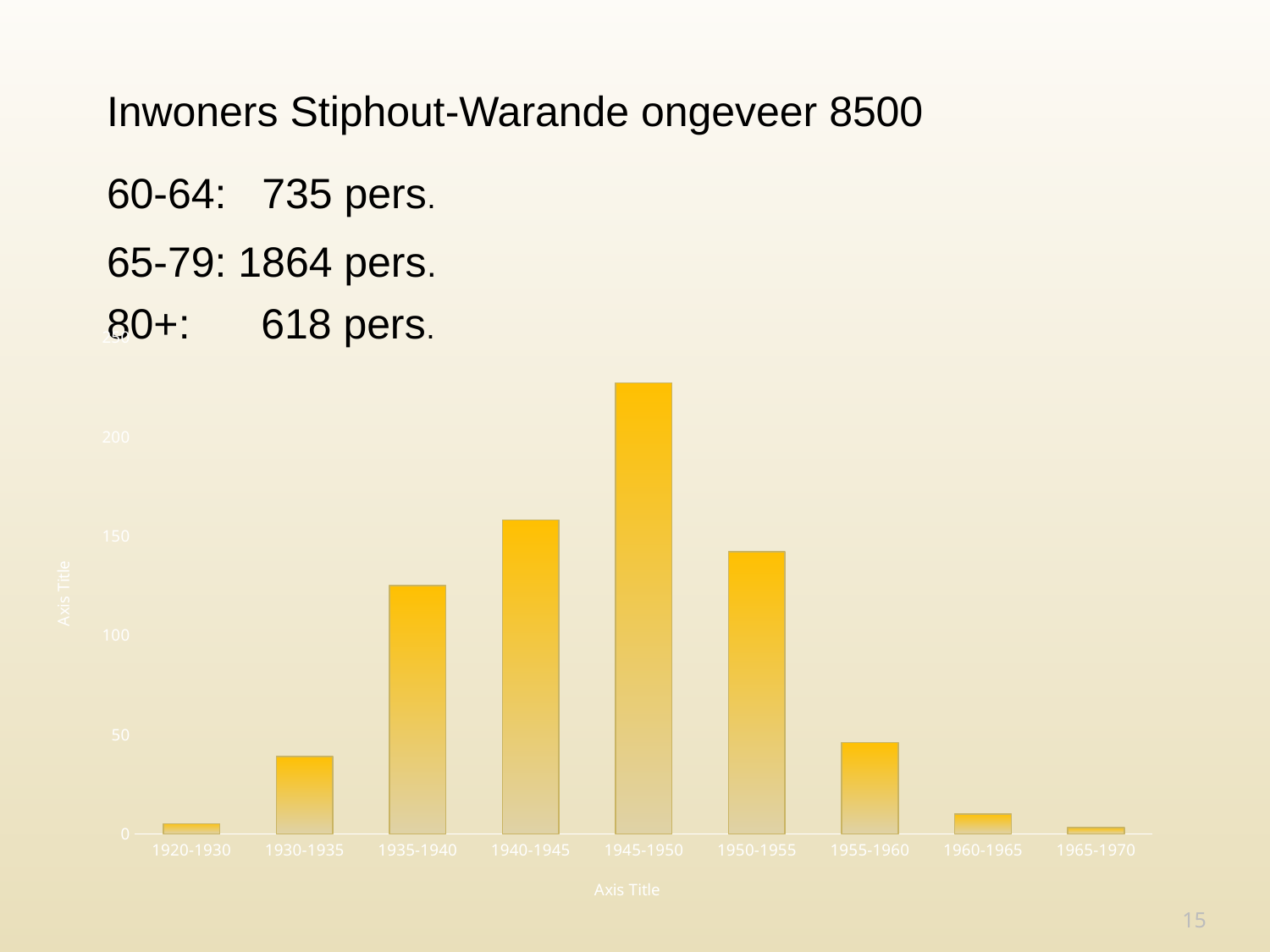
What text is shown as the title of the horizontal axis? Axis Title Do the values rise or fall from 1920-1930 to 1945-1950? rise Is the value for 1945-1950 greater or less than 200? greater Is the value for 1960-1965 greater or less than 50? less Is the value for 1935-1940 greater or less than 100? greater How many categories are shown on the x axis of the chart? 9 Which is larger, the value for 1940-1945 or the value for 1950-1955? 1940-1945 What kind of chart is shown on the slide? bar chart Which category has the highest bar in the chart? 1945-1950